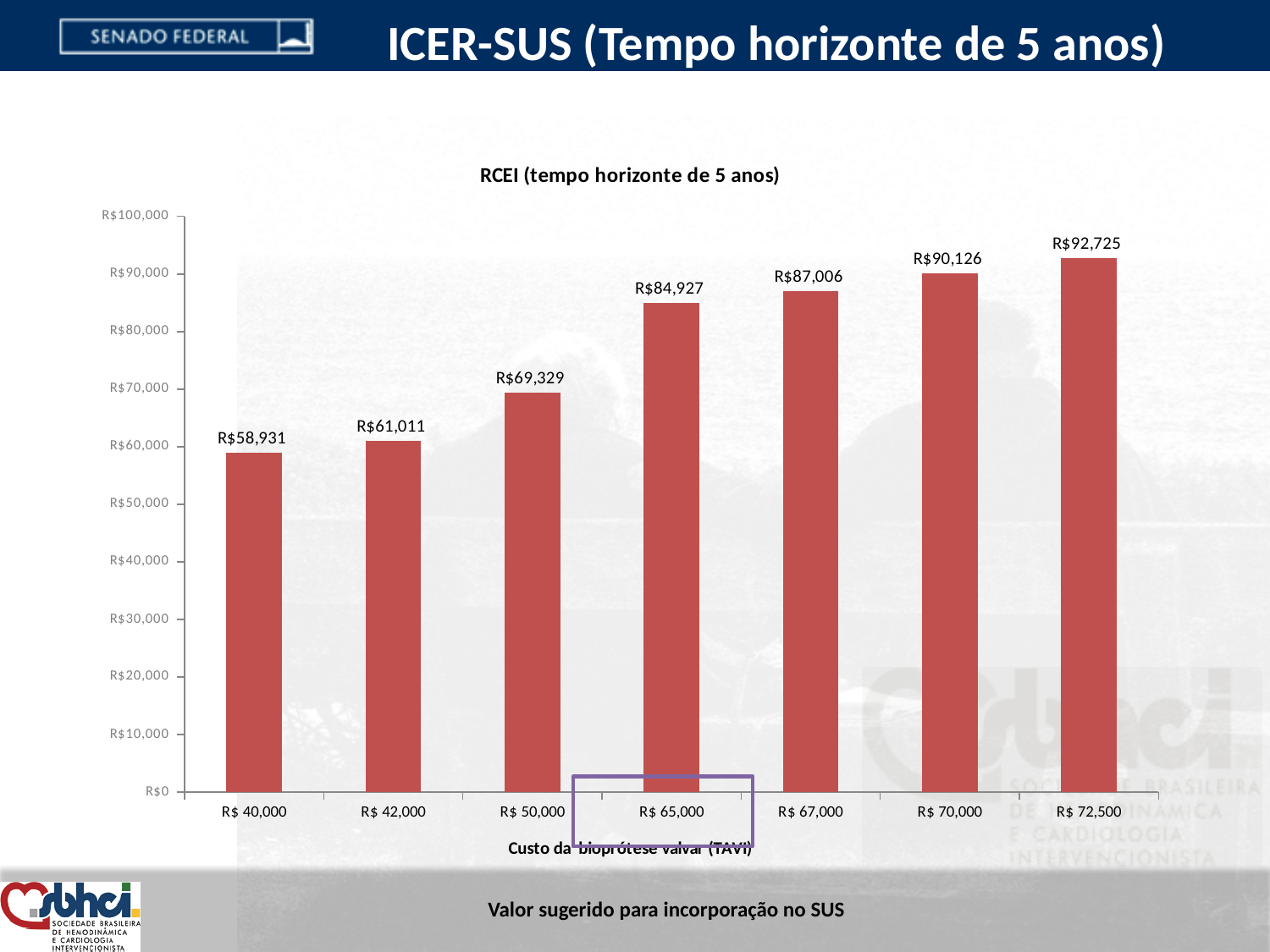
How many bioprosthesis cost categories are shown on the x axis? 7 What is the difference between the RCEI values for R$ 67,000 and R$ 65,000? R$2,079 What kind of chart is shown on the slide? bar chart Which bioprosthesis cost category has the highest RCEI value? R$ 72,500 Is the RCEI value for R$ 67,000 greater or less than R$80,000? greater Do the RCEI values rise or fall as the bioprosthesis cost increases along the x axis? rise What is the RCEI value for a bioprosthesis cost of R$ 70,000? R$90,126 Which bioprosthesis cost category has the lowest RCEI value? R$ 40,000 What is the difference between the RCEI values for R$ 72,500 and R$ 40,000? R$33,794 Which has a larger RCEI value, R$ 50,000 or R$ 42,000? R$ 50,000 What is the RCEI value for a bioprosthesis cost of R$ 40,000? R$58,931 What is the RCEI value for a bioprosthesis cost of R$ 65,000? R$84,927